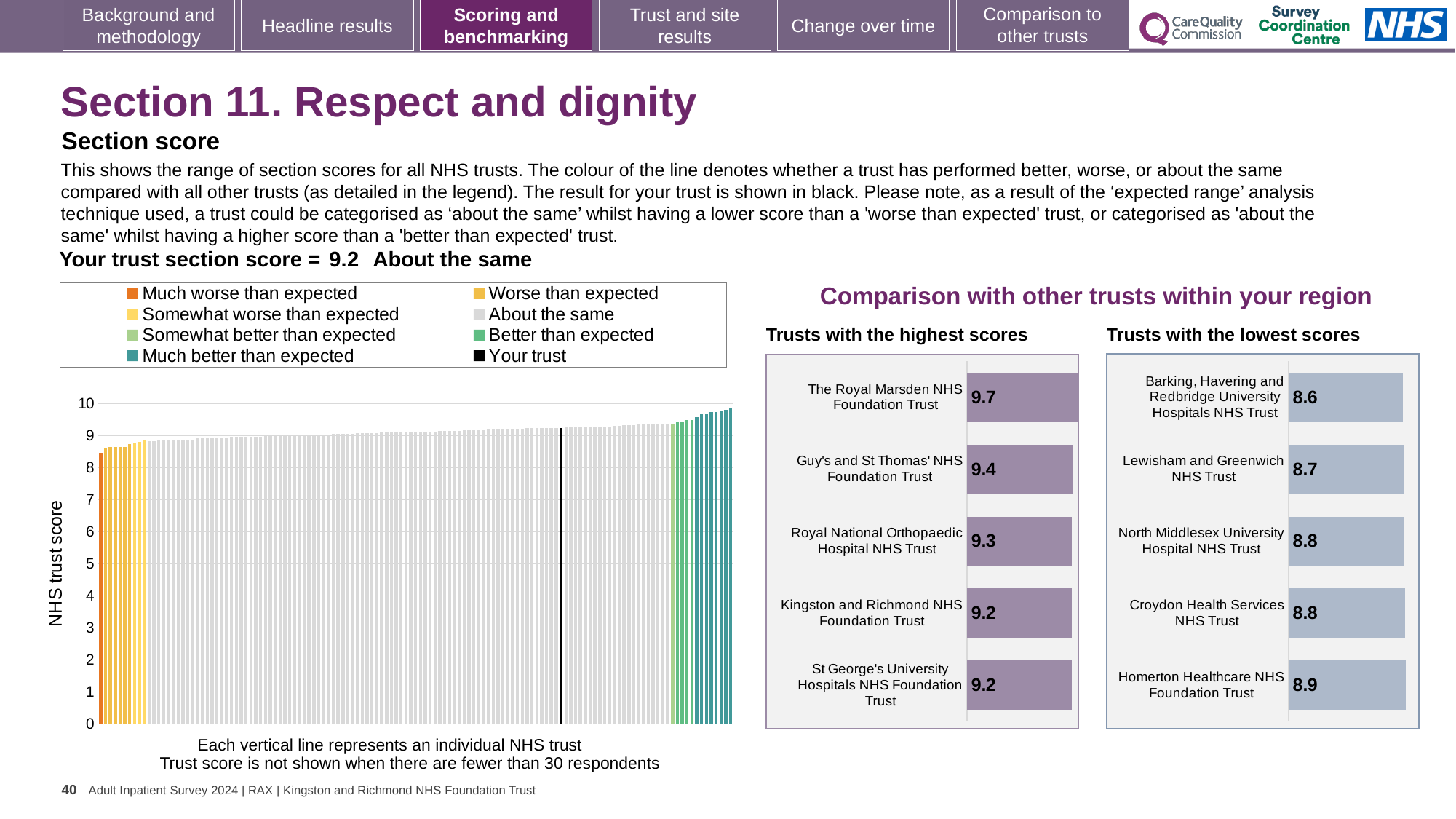
In the 'Trusts with the lowest scores' chart, what is the score for Lewisham and Greenwich NHS Trust? 8.7 What kind of chart is the large chart on the left with the y-axis labelled 'NHS trust score'? bar chart In the 'Trusts with the highest scores' chart, how many trusts are shown? 5 In the 'Trusts with the highest scores' chart, what is the difference between the scores of The Royal Marsden NHS Foundation Trust and Guy's and St Thomas' NHS Foundation Trust? 0.3 In the 'Trusts with the highest scores' chart, what is the score for Guy's and St Thomas' NHS Foundation Trust? 9.4 In the large chart on the left, is the value for the black 'Your trust' bar greater or less than 9? greater In the 'Trusts with the lowest scores' chart, what is the difference between the scores of Homerton Healthcare NHS Foundation Trust and Barking, Havering and Redbridge University Hospitals NHS Trust? 0.3 In the large chart on the left, how many entries does the legend list? 8 In the large chart on the left, what is the label on the y axis? NHS trust score In the 'Trusts with the lowest scores' chart, which trust has the lowest score? Barking, Havering and Redbridge University Hospitals NHS Trust In the 'Trusts with the lowest scores' chart, which has the higher score: Homerton Healthcare NHS Foundation Trust or Barking, Havering and Redbridge University Hospitals NHS Trust? Homerton Healthcare NHS Foundation Trust In the 'Trusts with the highest scores' chart, which trust has the highest score? The Royal Marsden NHS Foundation Trust